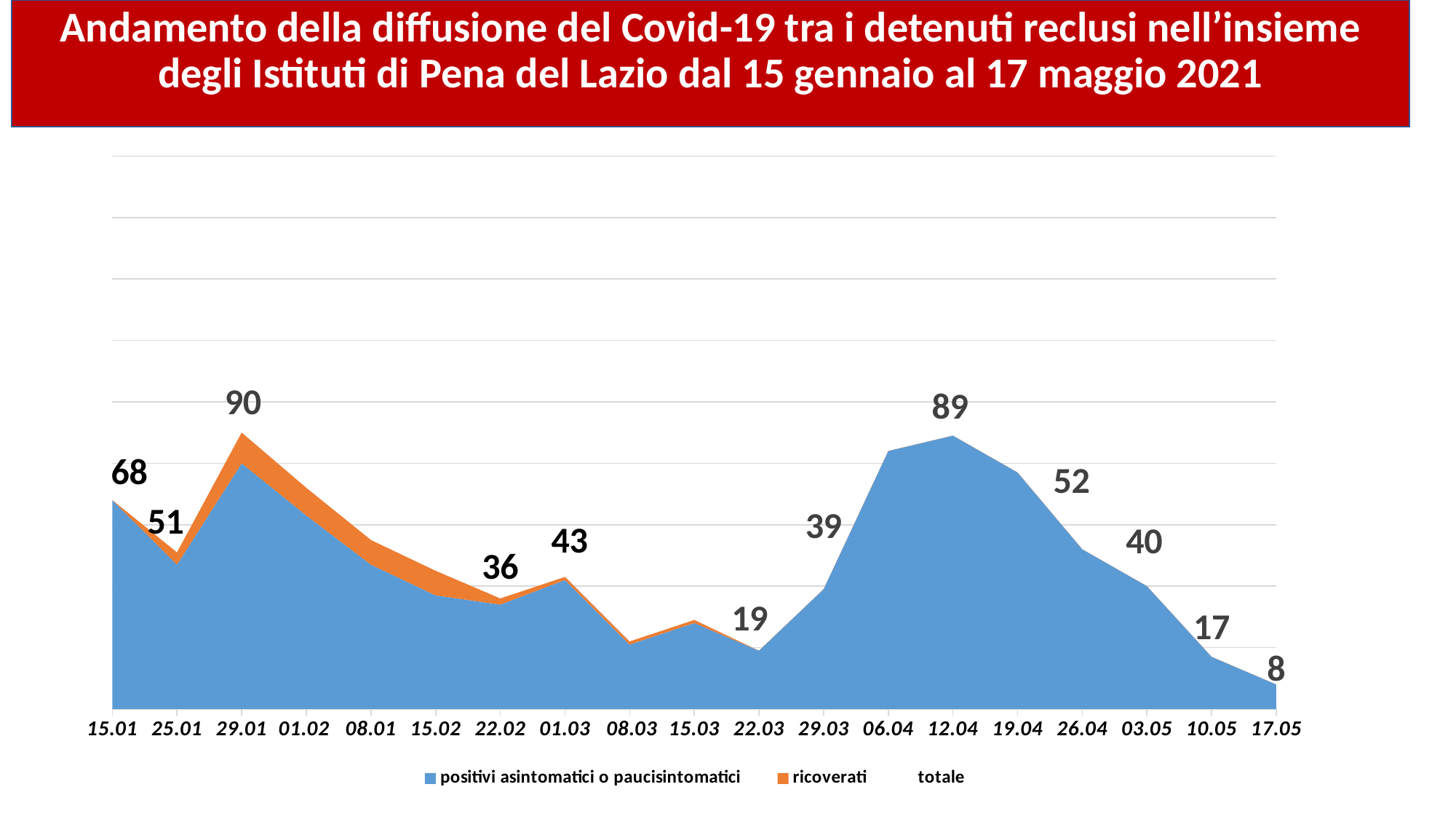
Which date has the highest total value? 29.01 What is the total value shown for 12.04? 89 What is the total value shown for 29.01? 90 What is the total value shown for 17.05? 8 What kind of chart is shown on the slide? Area chart How many series does the legend list? 3 Do the total values rise or fall from 12.04 to 17.05? Fall How many dates are shown on the x axis? 19 What is the difference between the total values for 15.01 and 25.01? 17 Which has a larger total value, 26.04 or 03.05? 26.04 Which date has the lowest total value? 17.05 What is the total value shown for 22.03? 19